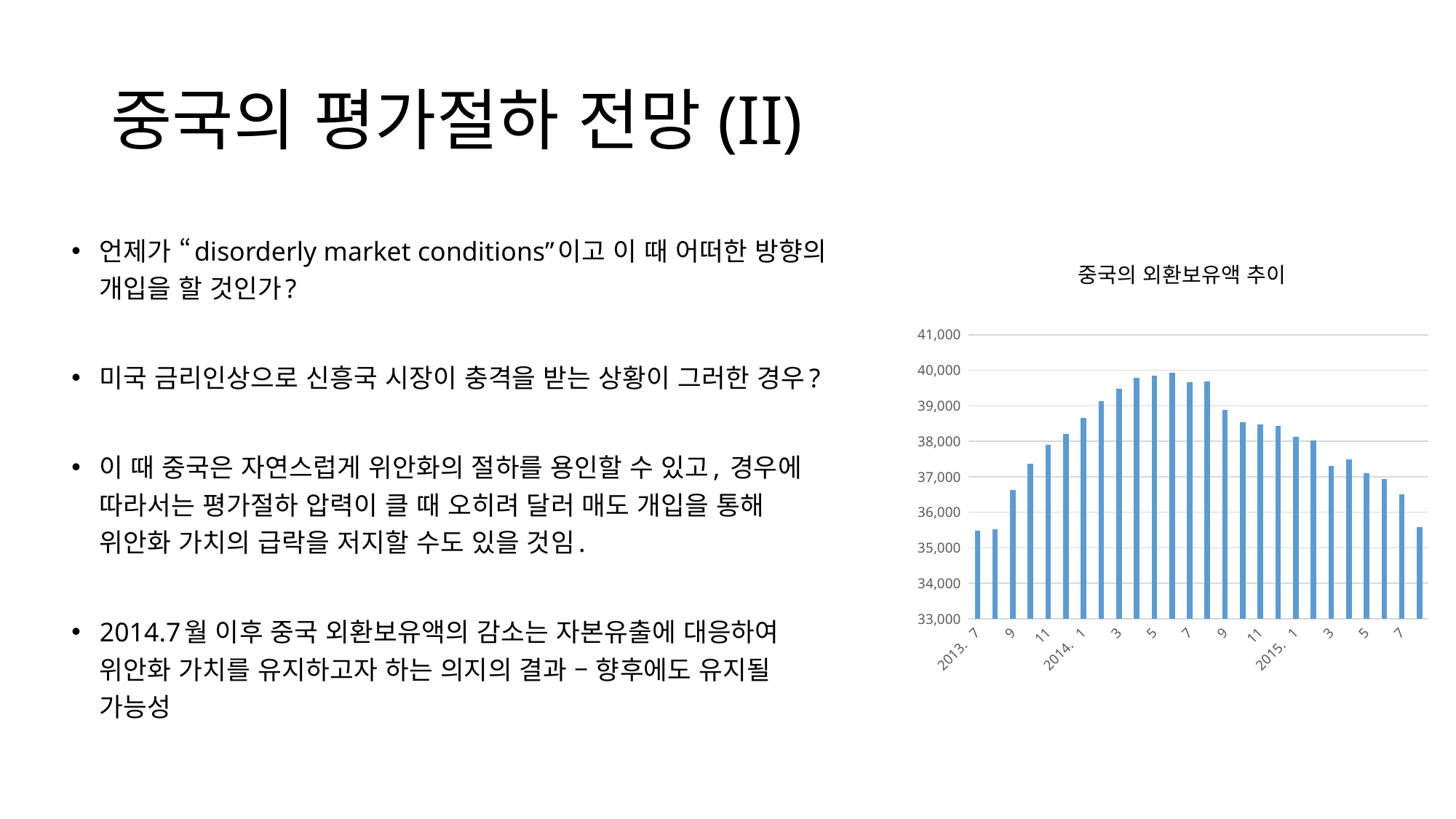
Is the value for 2014.7 greater or less than 39,000? greater How do the values change from 2014.7 to 2015.7 along the x axis? they fall Is the value for 2013.7 greater or less than 36,000? less Which is higher, the value for 2014.1 or the value for 2015.1? 2014.1 Is the value for 2014.3 greater or less than 39,000? greater What is the highest value shown on the chart's vertical axis? 41,000 Which is higher, the value for 2014.7 or the value for 2015.7? 2014.7 What is the title of the chart on the slide? 중국의 외환보유액 추이 What kind of chart is shown on the slide? bar chart